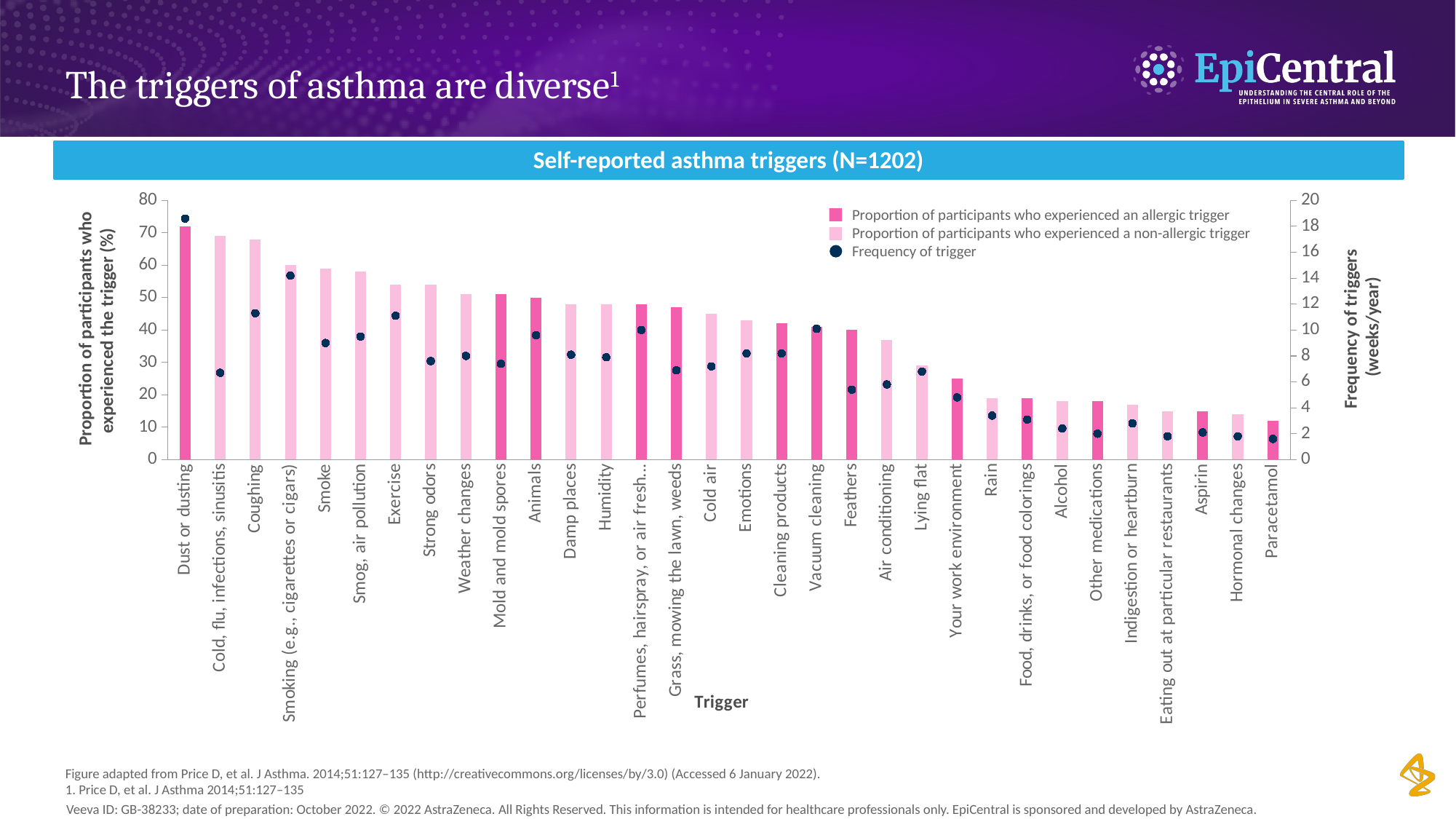
Do the bar values rise or fall moving from left to right along the x axis? Fall How many series does the legend list? 3 What is the title of the chart? Self-reported asthma triggers (N=1202) Which trigger has the lowest proportion of participants who experienced it? Paracetamol Is the proportion of participants for Paracetamol greater or less than 20%? less Which has a higher proportion of participants, Exercise or Emotions? Exercise Is the frequency of trigger for Dust or dusting greater or less than 16 weeks/year? greater Which trigger has the highest proportion of participants who experienced it? Dust or dusting Is the proportion of participants for Coughing greater or less than 60%? greater How many triggers are listed along the x axis of the chart? 32 What kind of chart is shown on the slide? Bar chart with a line/dot series (combination chart)